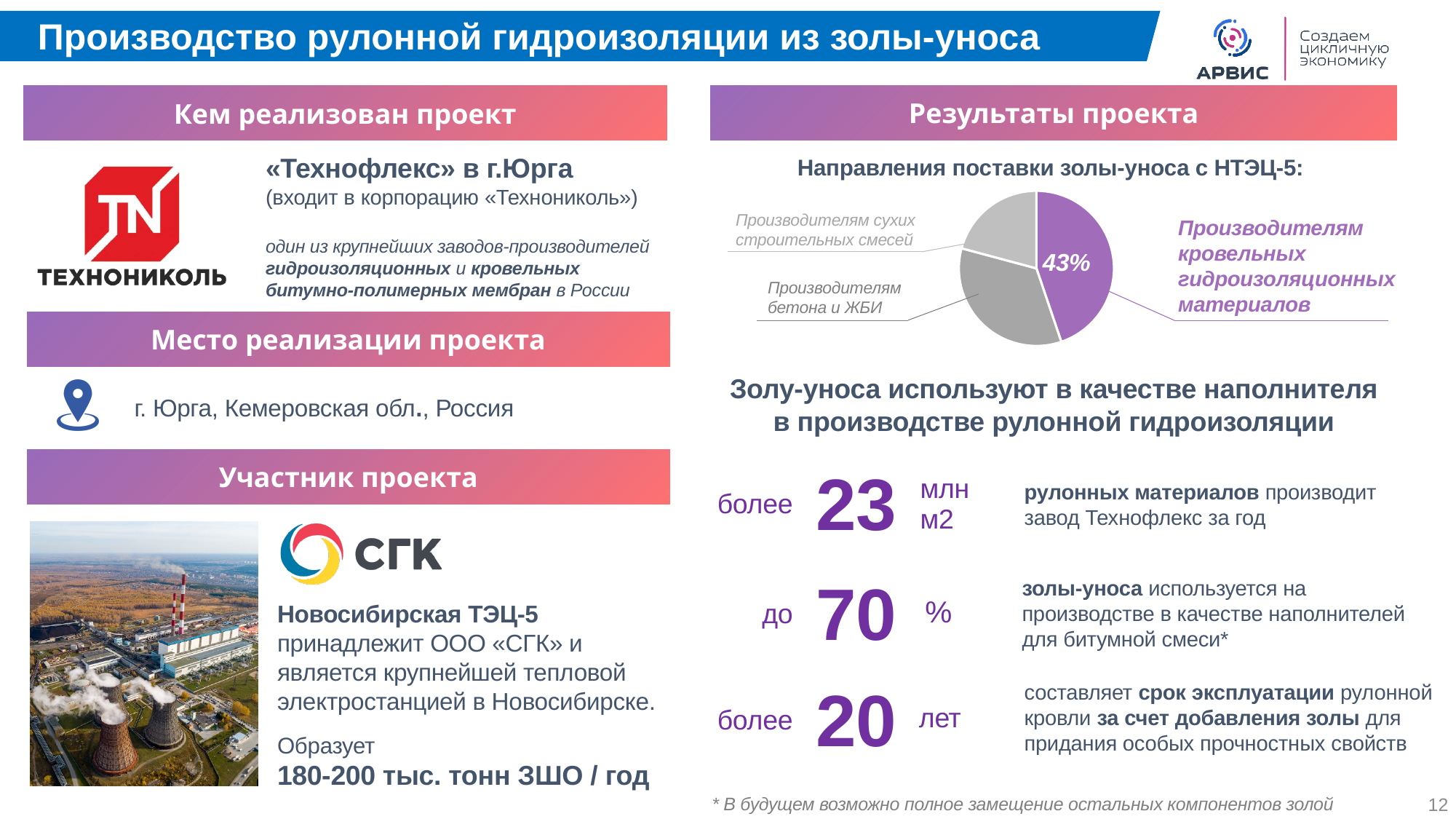
What is the only percentage value printed on the pie chart? 43% How many slices does the pie chart «Направления поставки золы-уноса с НТЭЦ-5» have? 3 In the pie chart, which slice is larger: «Производителям бетона и ЖБИ» or «Производителям сухих строительных смесей»? Производителям бетона и ЖБИ What kind of chart is shown under «Направления поставки золы-уноса с НТЭЦ-5»? Pie chart Which category receives the smallest share of fly ash in the pie chart? Производителям сухих строительных смесей What colour is the slice labelled 43% in the pie chart? Purple Which category receives the largest share of fly ash in the pie chart? Производителям кровельных гидроизоляционных материалов What is the title of the pie chart on the slide? Направления поставки золы-уноса с НТЭЦ-5: In the pie chart, what share of fly ash goes to «Производителям кровельных гидроизоляционных материалов»? 43% In the pie chart, which slice is larger: «Производителям кровельных гидроизоляционных материалов» or «Производителям бетона и ЖБИ»? Производителям кровельных гидроизоляционных материалов